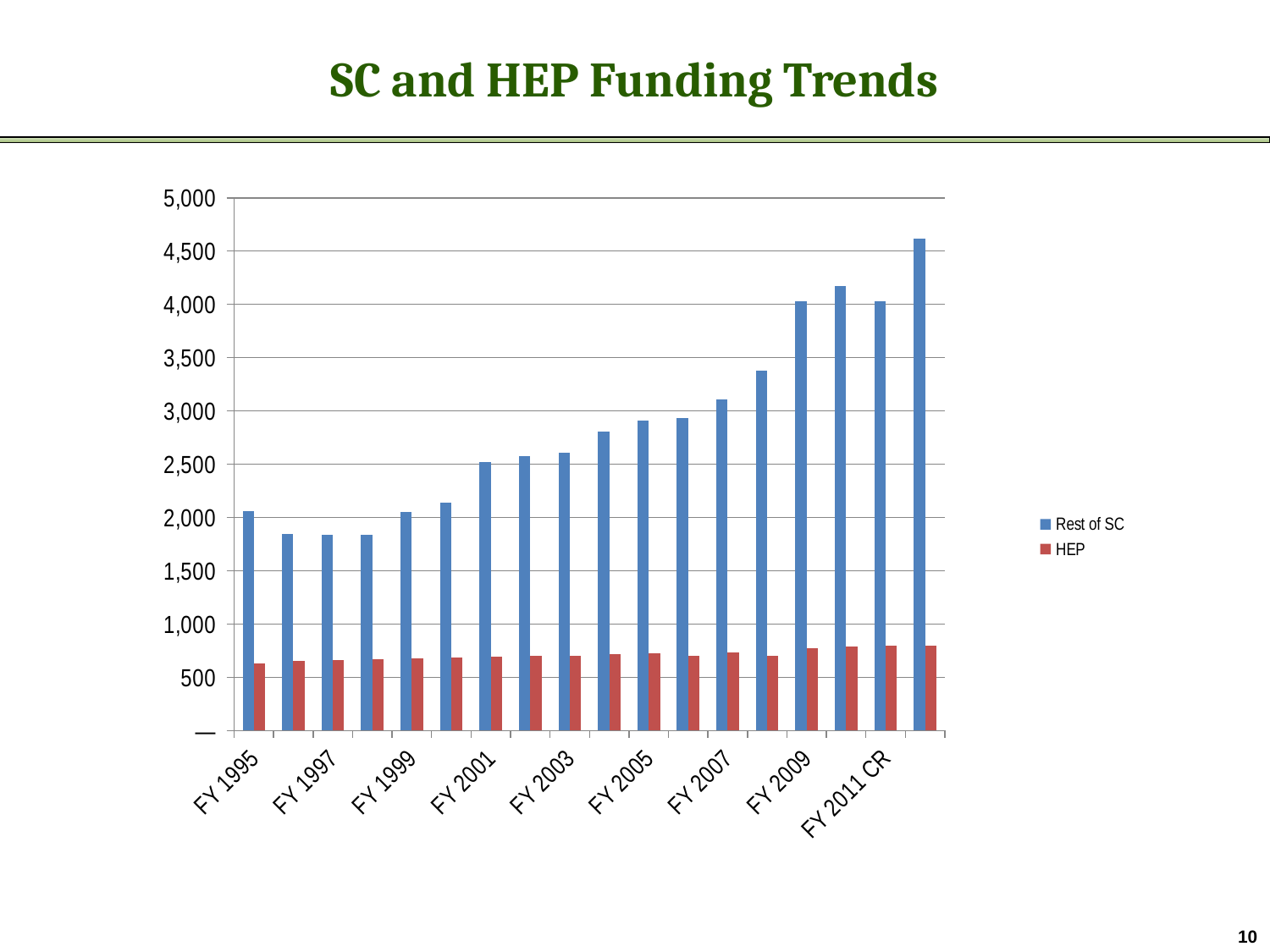
What is the title of the chart? SC and HEP Funding Trends What kind of chart is shown on the slide? bar chart Is the HEP value for FY 2011 CR greater or less than 1,000? less What are the two series named in the legend? Rest of SC and HEP How many series does the legend list? 2 In which fiscal year is the HEP value lowest? FY 1995 Is the Rest of SC value for FY 2011 CR greater or less than 4,500? less Does the Rest of SC series generally rise or fall from FY 1995 to FY 2011 CR? rise Is the Rest of SC value for FY 1997 greater or less than 2,000? less Which is larger, the Rest of SC value for FY 2009 or for FY 2007? FY 2009